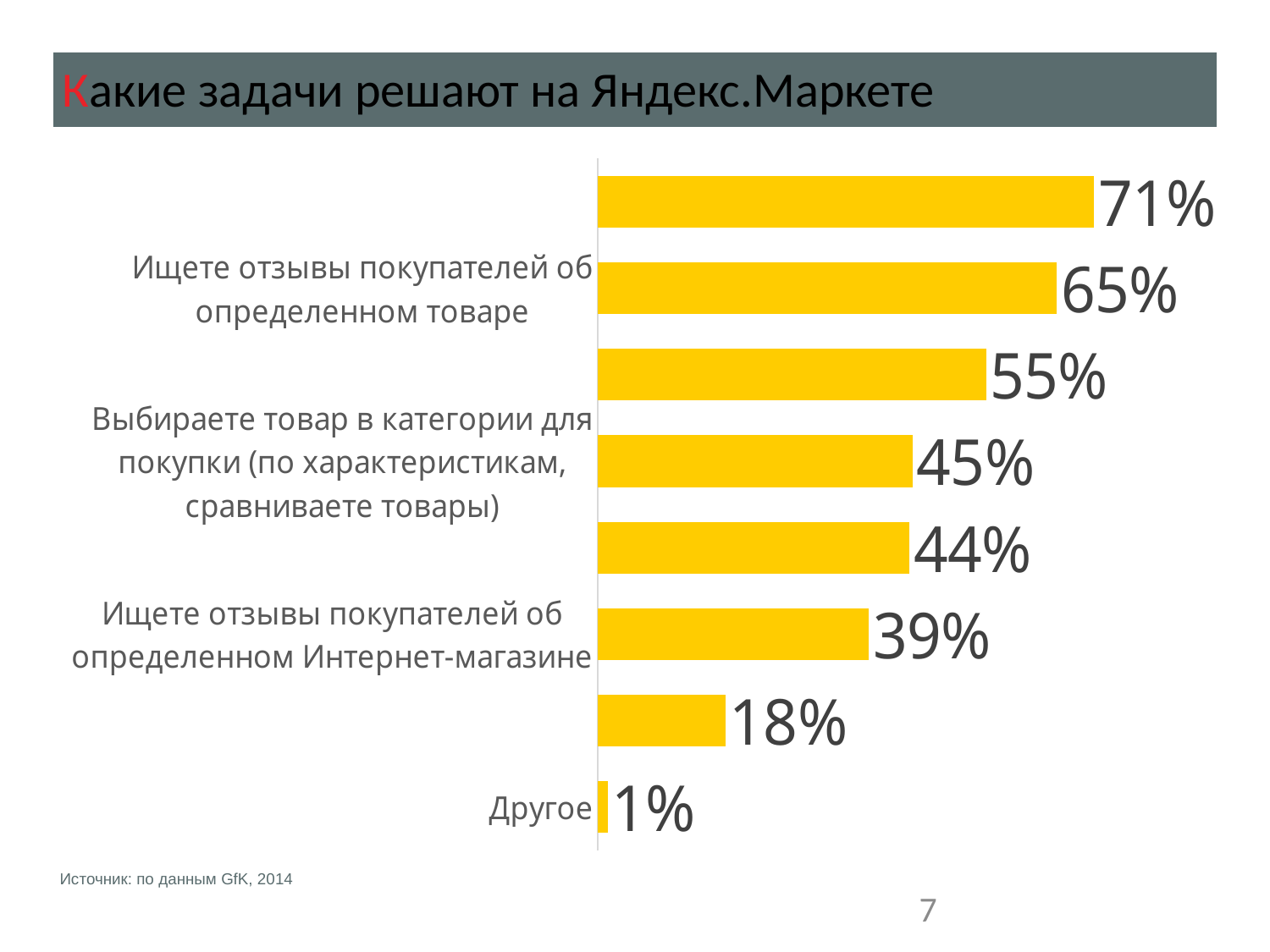
What is the difference between the values for "Ищете отзывы покупателей об определенном товаре" and "Ищете отзывы покупателей об определенном Интернет-магазине"? 26% What is the highest value shown in the chart? 71% What is the title of the slide? Какие задачи решают на Яндекс.Маркете Which category has the lowest value? Другое What kind of chart is shown on the slide? bar chart What is the value for "Другое"? 1% What is the value for "Ищете отзывы покупателей об определенном товаре"? 65% What is the value for "Ищете отзывы покупателей об определенном Интернет-магазине"? 39% What source is cited for the chart data? по данным GfK, 2014 What is the value for "Выбираете товар в категории для покупки (по характеристикам, сравниваете товары)"? 45% Which is larger: the value for "Выбираете товар в категории для покупки" or the value for "Ищете отзывы покупателей об определенном Интернет-магазине"? Выбираете товар в категории для покупки How many bars does the chart contain? 8